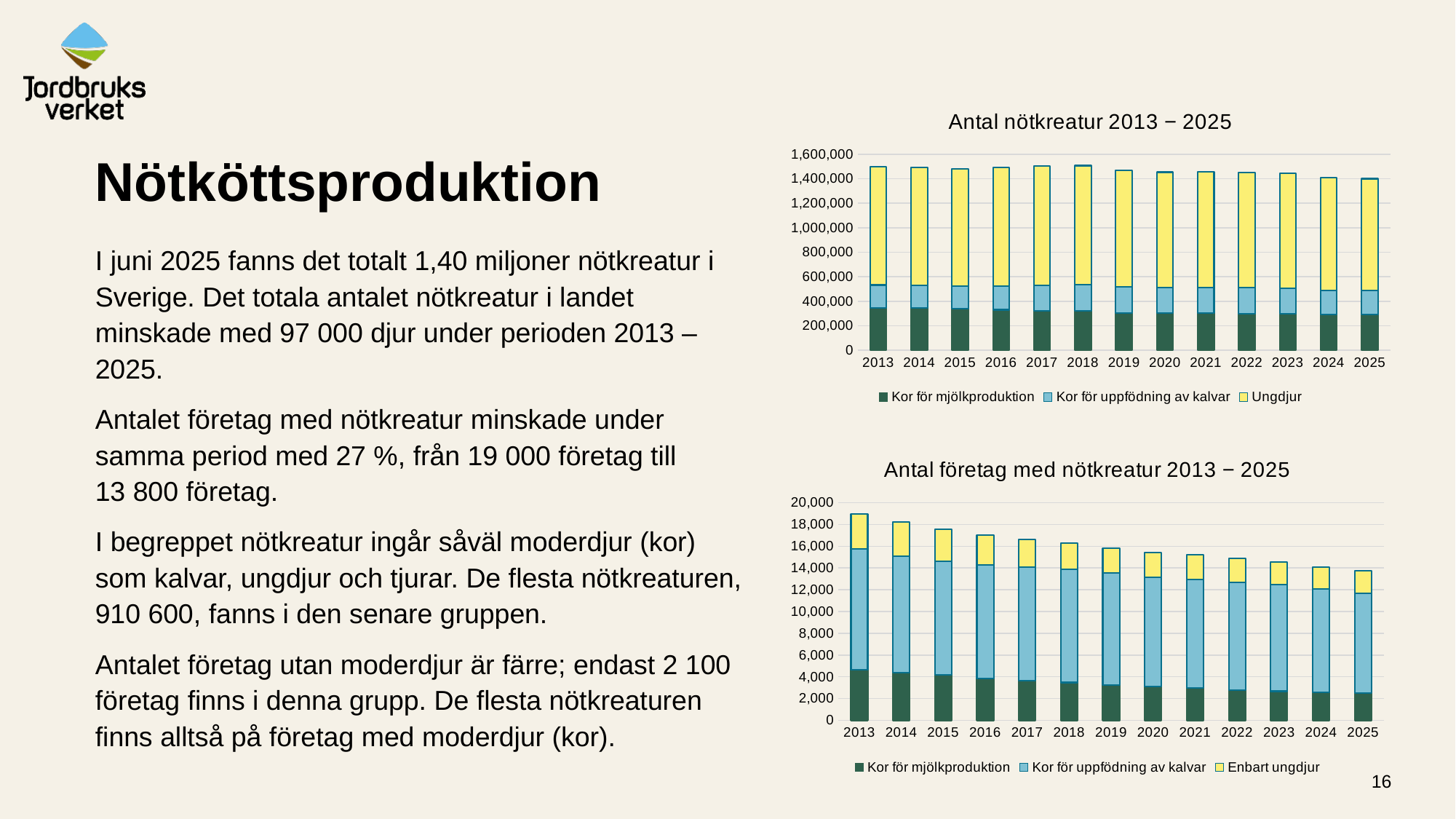
In the bottom chart, which is larger: the total bar for 2013 or the total bar for 2025? 2013 In the bottom chart 'Antal företag med nötkreatur 2013 − 2025', is the 'Kor för mjölkproduktion' segment for 2025 greater or less than 4,000? less In the top chart 'Antal nötkreatur 2013 − 2025', is the 'Kor för mjölkproduktion' segment for 2013 greater or less than 400,000? less What kind of chart is the top chart titled 'Antal nötkreatur 2013 − 2025'? Stacked bar chart In the bottom chart 'Antal företag med nötkreatur 2013 − 2025', which year has the highest total bar? 2013 How many series does the legend of the top chart 'Antal nötkreatur 2013 − 2025' list? 3 In the bottom chart 'Antal företag med nötkreatur 2013 − 2025', is the total bar for 2013 greater or less than 18,000? greater In the bottom chart 'Antal företag med nötkreatur 2013 − 2025', do the total values rise or fall from 2013 to 2025? Fall What is the third legend entry of the bottom chart 'Antal företag med nötkreatur 2013 − 2025'? Enbart ungdjur How many years are shown on the x axis of the bottom chart 'Antal företag med nötkreatur 2013 − 2025'? 13 In the bottom chart 'Antal företag med nötkreatur 2013 − 2025', which year has the lowest total bar? 2025